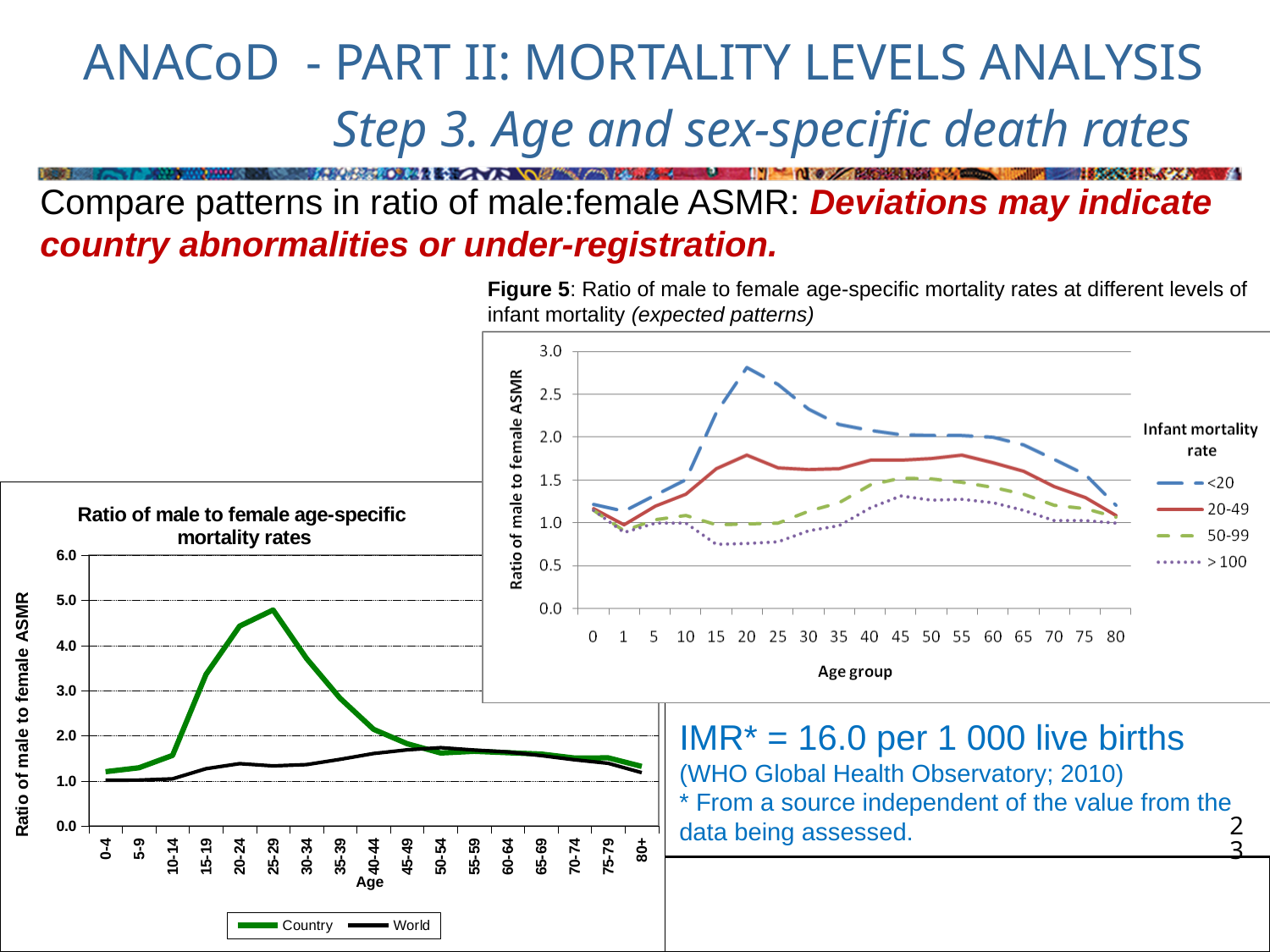
In the bottom-left chart 'Ratio of male to female age-specific mortality rates', is the Country value for age group 25-29 greater or less than 4.0? greater In the bottom-left chart 'Ratio of male to female age-specific mortality rates', what kind of chart is shown? Line chart In Figure 5 (top-right chart), is the value of the <20 series at age group 20 greater or less than 2.5? greater In the bottom-left chart 'Ratio of male to female age-specific mortality rates', is the World value for age group 45-49 greater or less than 1.0? greater In Figure 5 (top-right chart), how many series does the legend list? 4 In Figure 5 (top-right chart), which infant mortality rate series has the highest value at age group 20? <20 In the bottom-left chart 'Ratio of male to female age-specific mortality rates', does the Country series rise or fall between age groups 25-29 and 45-49? Fall In the bottom-left chart 'Ratio of male to female age-specific mortality rates', at which age group does the Country series reach its highest value? 25-29 In Figure 5 (top-right chart), what is the title of the legend? Infant mortality rate In the bottom-left chart 'Ratio of male to female age-specific mortality rates', how many age groups are shown on the x axis? 17 In the bottom-left chart 'Ratio of male to female age-specific mortality rates', how many series does the legend list? 2 In the bottom-left chart 'Ratio of male to female age-specific mortality rates', which series has the larger value at age group 20-24, Country or World? Country